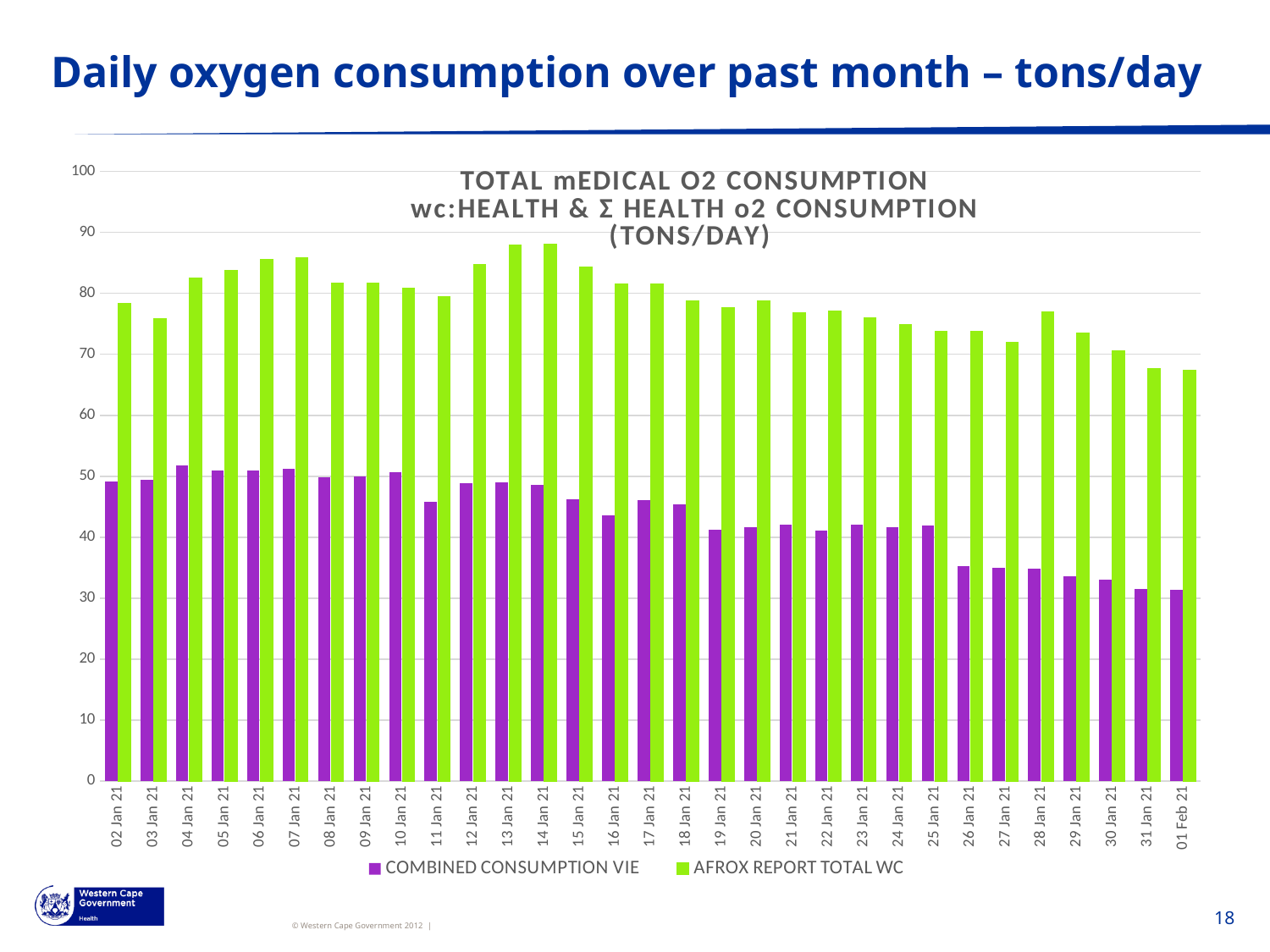
What colour are the AFROX REPORT TOTAL WC bars? Green Is the AFROX REPORT TOTAL WC value for 02 Jan 21 greater or less than 80? less Which date has the larger COMBINED CONSUMPTION VIE value, 04 Jan 21 or 11 Jan 21? 04 Jan 21 Is the COMBINED CONSUMPTION VIE value for 26 Jan 21 greater or less than 40? less Which date has the larger AFROX REPORT TOTAL WC value, 02 Jan 21 or 03 Jan 21? 02 Jan 21 Is the AFROX REPORT TOTAL WC value for 01 Feb 21 greater or less than 70? less How many series does the chart legend list? 2 Do the COMBINED CONSUMPTION VIE values generally rise or fall from 02 Jan 21 to 01 Feb 21? fall What kind of chart is shown on the slide? Bar chart How many dates are shown along the x axis of the chart? 31